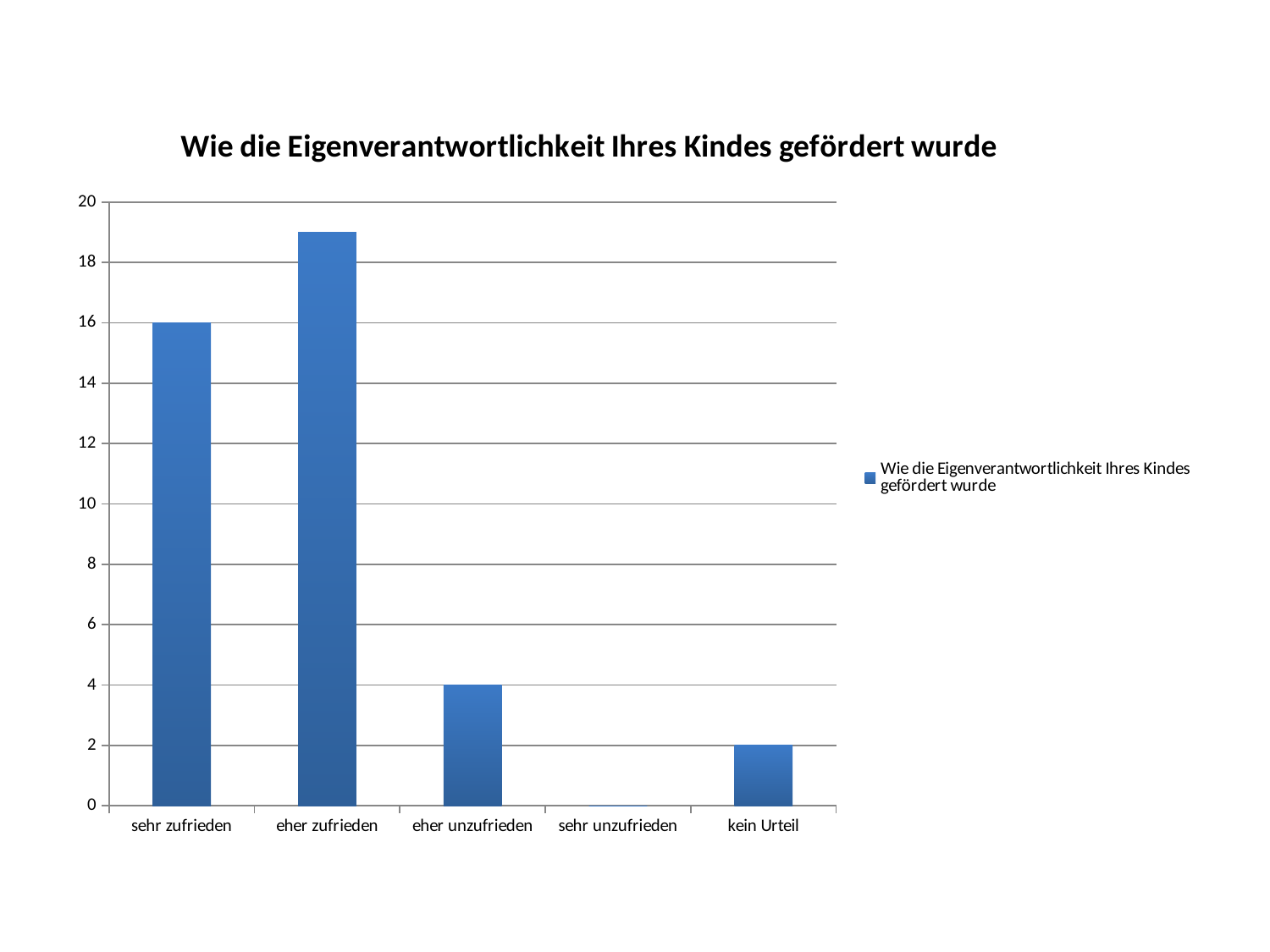
What is the value for "sehr unzufrieden"? 0 What is the value for "eher unzufrieden"? 4 What is the value for "kein Urteil"? 2 How many categories are shown on the x axis? 5 Is the value for "eher zufrieden" greater or less than 18? greater What is the title of the chart? Wie die Eigenverantwortlichkeit Ihres Kindes gefördert wurde Which category has the lowest value? sehr unzufrieden Which category has the highest value? eher zufrieden Which is larger, the value for "sehr zufrieden" or the value for "eher zufrieden"? eher zufrieden What type of chart is shown on the slide? bar chart What is the value for "sehr zufrieden"? 16 What is the difference between the values for "sehr zufrieden" and "eher unzufrieden"? 12